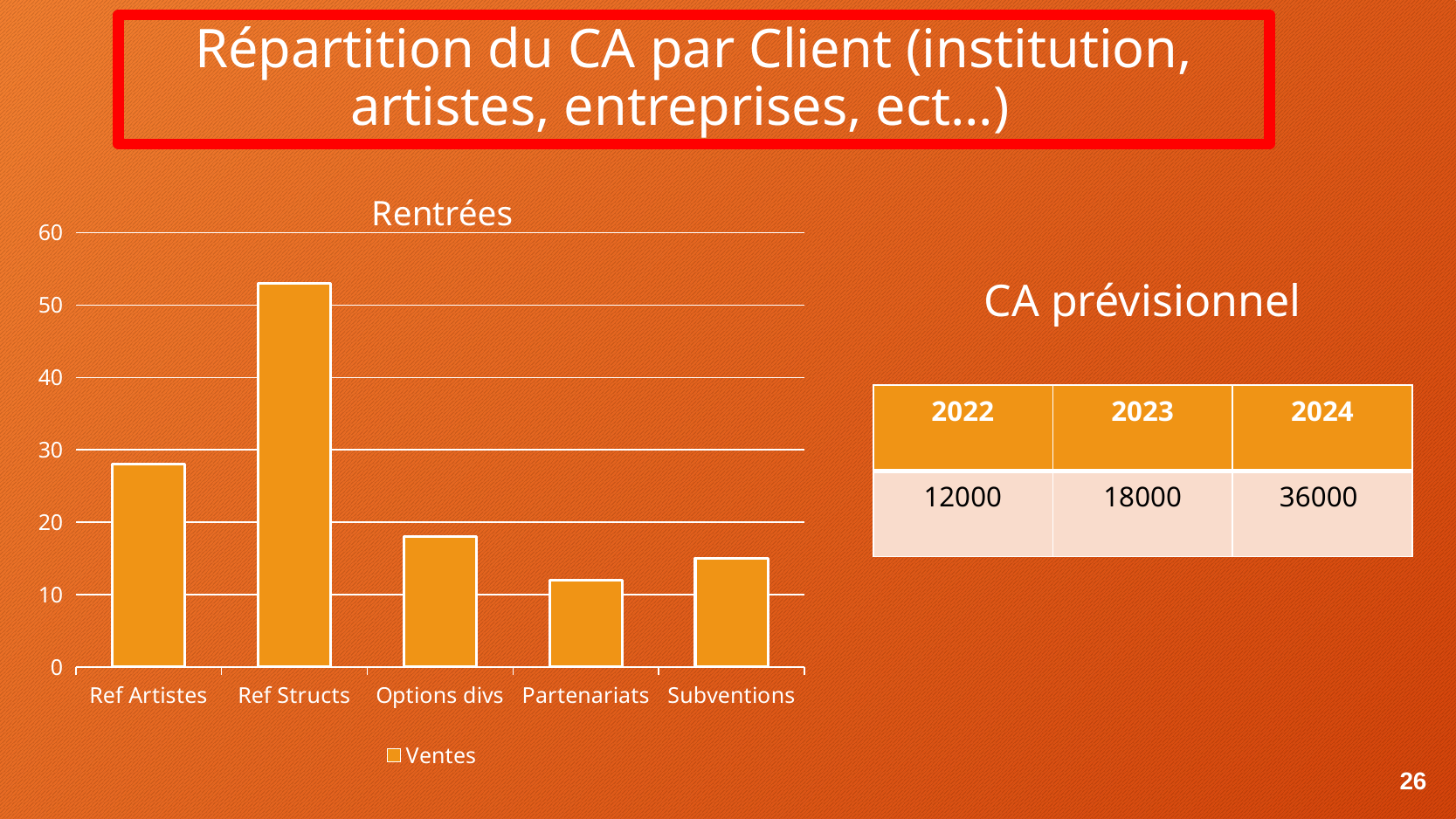
How many series does the chart legend list? 1 What is the title of the chart? Rentrées Is the value for Ref Artistes greater or less than 30? less Is the value for Ref Structs greater or less than 50? greater Which category has the highest bar in the chart? Ref Structs Is the value for Partenariats greater or less than 10? greater Which category has the lowest bar in the chart? Partenariats What type of chart is shown on the slide? bar chart What series name appears in the chart legend? Ventes How many categories are shown on the x axis of the chart? 5 Which is larger, the value for Ref Artistes or the value for Options divs? Ref Artistes